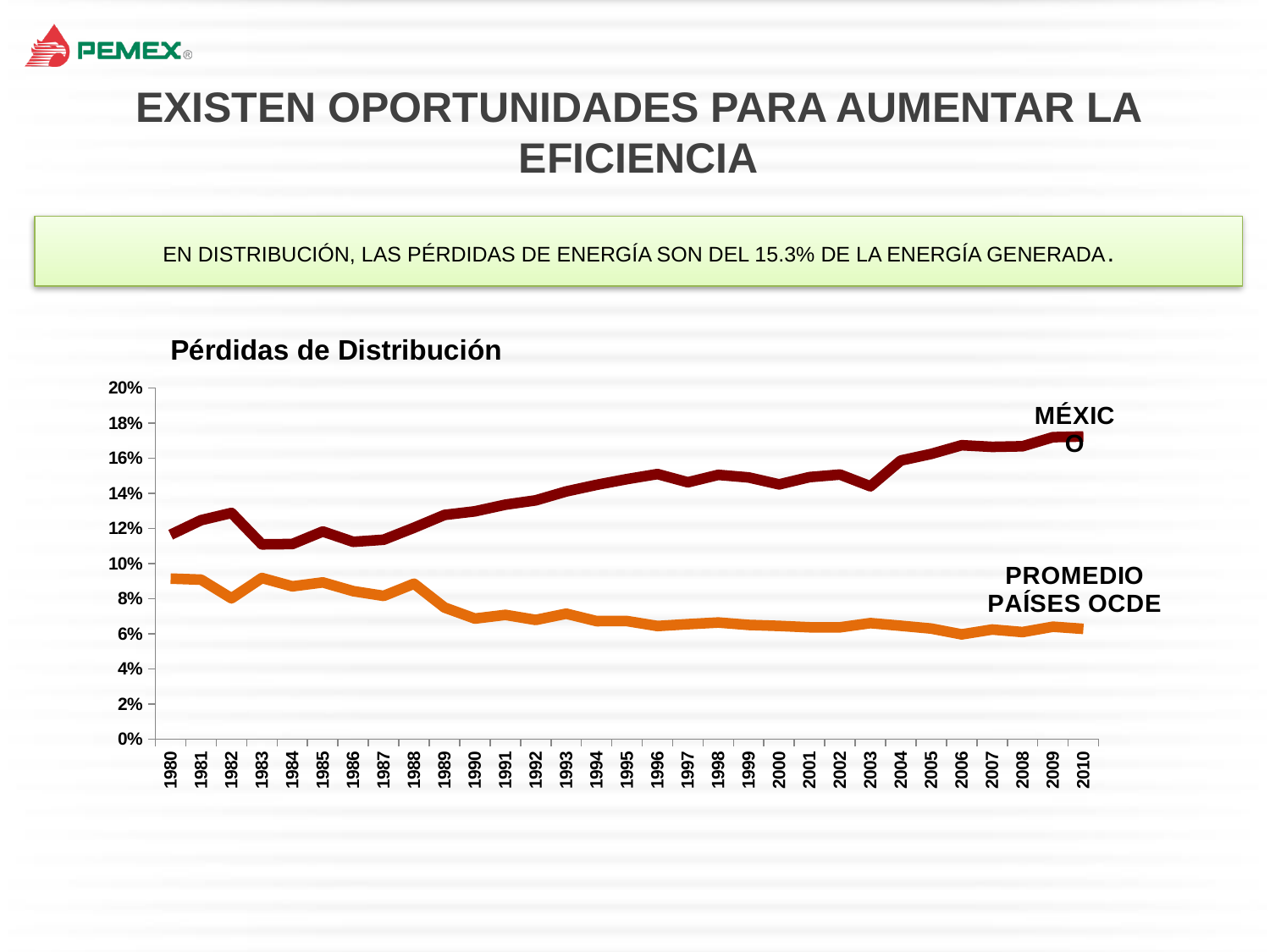
Which series is drawn in dark red? MÉXICO What is the title of the chart? Pérdidas de Distribución Is the value for PROMEDIO PAÍSES OCDE in 2010 greater or less than 8%? less Is the value for PROMEDIO PAÍSES OCDE in 1980 greater or less than 8%? greater Does the PROMEDIO PAÍSES OCDE line rise or fall overall from 1980 to 2010? fall What kind of chart is shown on the slide? line chart How many years are shown along the x axis of the chart? 31 Does the MÉXICO line rise or fall overall from 1980 to 2010? rise In 2000, which series has the higher value, MÉXICO or PROMEDIO PAÍSES OCDE? MÉXICO How many series are plotted on the chart? 2 Is the value for MÉXICO in 1996 greater or less than 14%? greater